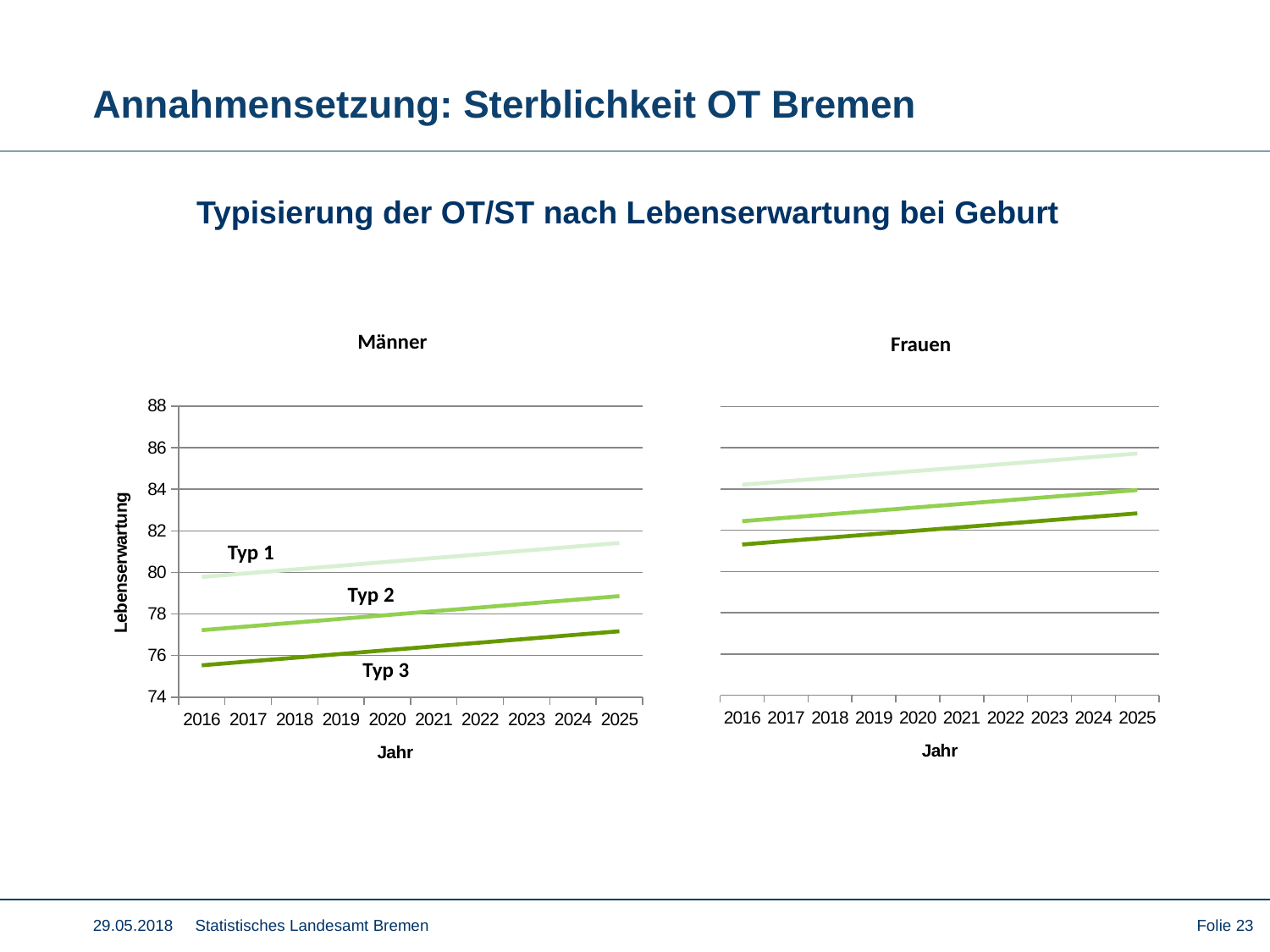
How many lines are plotted in the Männer chart? 3 In the Männer chart, is the value for Typ 3 in 2016 greater or less than 76? less What is the y-axis title of the Männer chart? Lebenserwartung In the Männer chart, which type has the highest life expectancy? Typ 1 What kind of chart is the Männer chart? line chart In the Männer chart, do the lines rise or fall from 2016 to 2025? rise In the Frauen chart, do the lines rise or fall from 2016 to 2025? rise How many years are shown on the x axis of the Männer chart? 10 In the Männer chart, which type has the lowest life expectancy? Typ 3 In the Männer chart, which is larger in 2020: Typ 1 or Typ 3? Typ 1 In the Männer chart, is the value for Typ 1 in 2025 greater or less than 80? greater In the Männer chart, is the value for Typ 2 in 2025 greater or less than 80? less